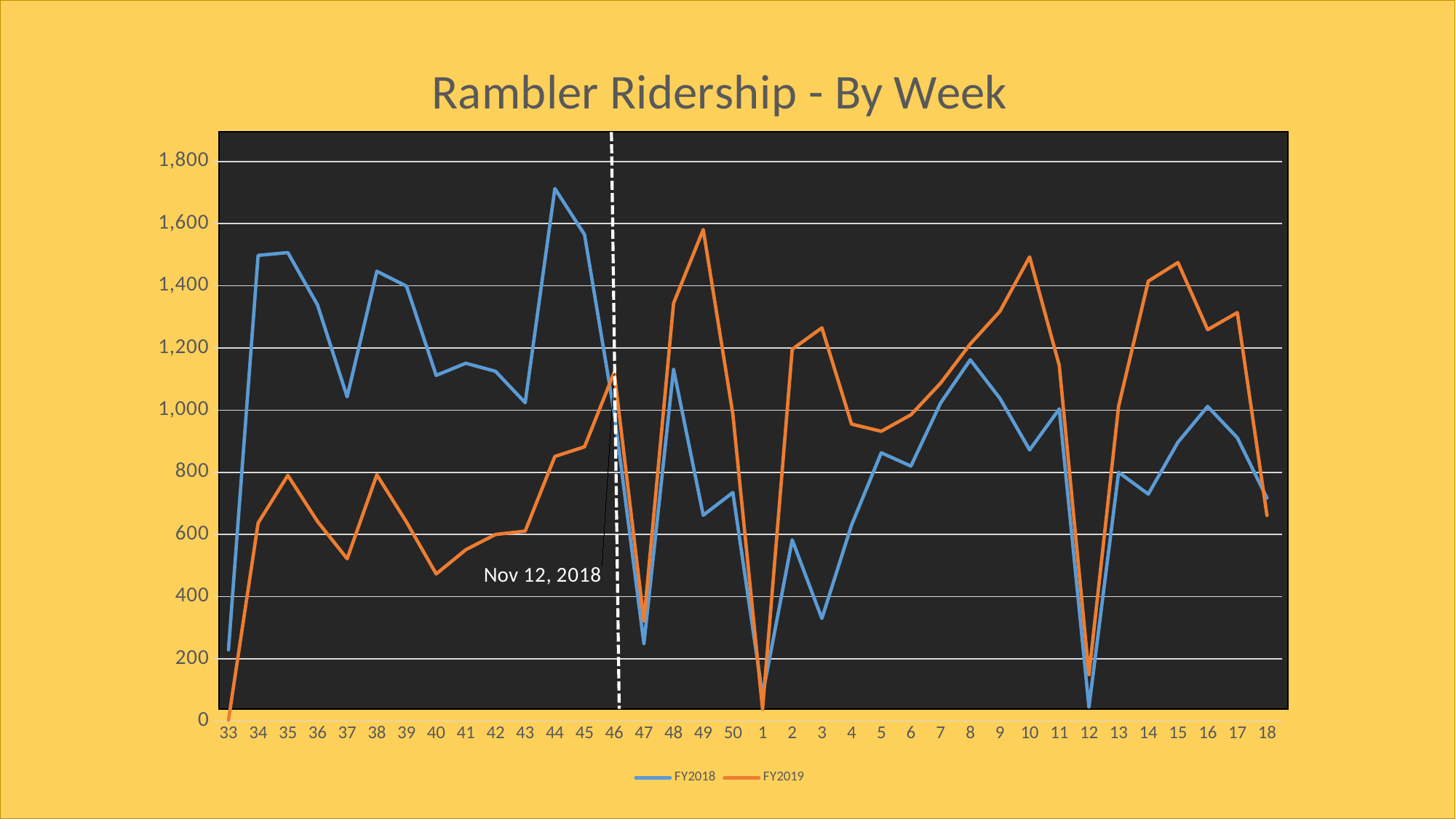
Is the FY2018 value for week 34 greater or less than 1,400? greater Is the FY2019 value for week 40 greater or less than 600? less In which week does the FY2018 series reach its highest value? 44 What kind of chart is shown on the slide? line chart How many series does the legend list? 2 At week 15, which series has the larger value, FY2018 or FY2019? FY2019 What date is written in the annotation next to the dashed vertical line? Nov 12, 2018 In which week does the FY2019 series reach its highest value? 49 In which week does the FY2018 series reach its lowest value? 12 How many week labels are shown along the x axis? 36 Is the FY2018 value for week 3 greater or less than 400? less At week 38, which series has the larger value, FY2018 or FY2019? FY2018